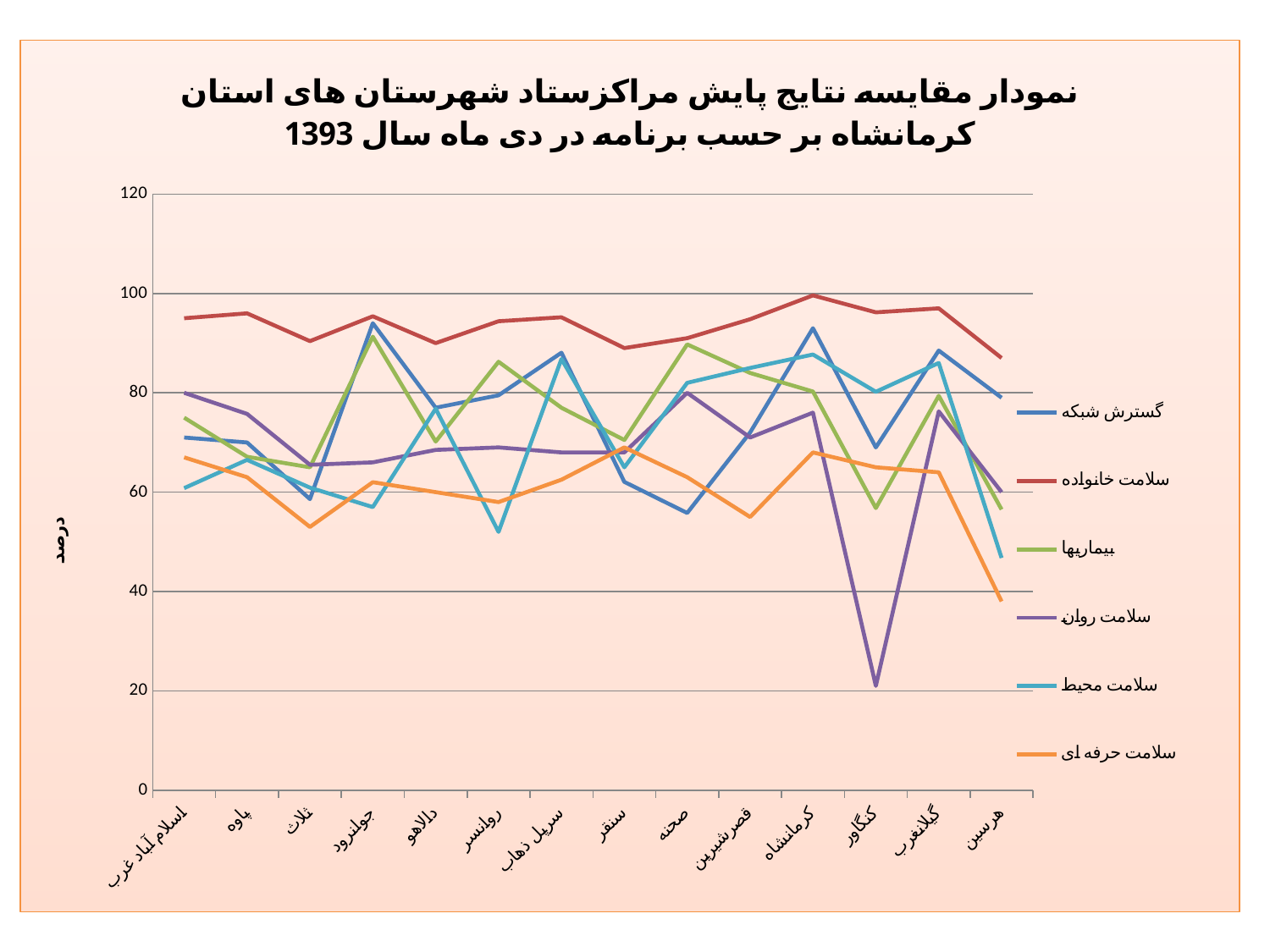
For the سلامت خانواده series, which category has the highest value? کرمانشاه Does the سلامت خانواده series rise or fall from گیلانغرب to هرسین? fall How many series does the legend list? 6 Which series stays highest across almost all categories? سلامت خانواده Is the value of سلامت خانواده at کرمانشاه greater or less than 80? greater For the سلامت روان series, which category has the lowest value? کنگاور What is the label on the vertical axis? درصد How many categories (cities) are shown on the x axis? 14 What kind of chart is shown on the slide? line chart Is the value of سلامت روان at کنگاور greater or less than 40? less Is the value of سلامت محیط at روانسر greater or less than 60? less At هرسین, which is larger: گسترش شبکه or سلامت حرفه ای? گسترش شبکه